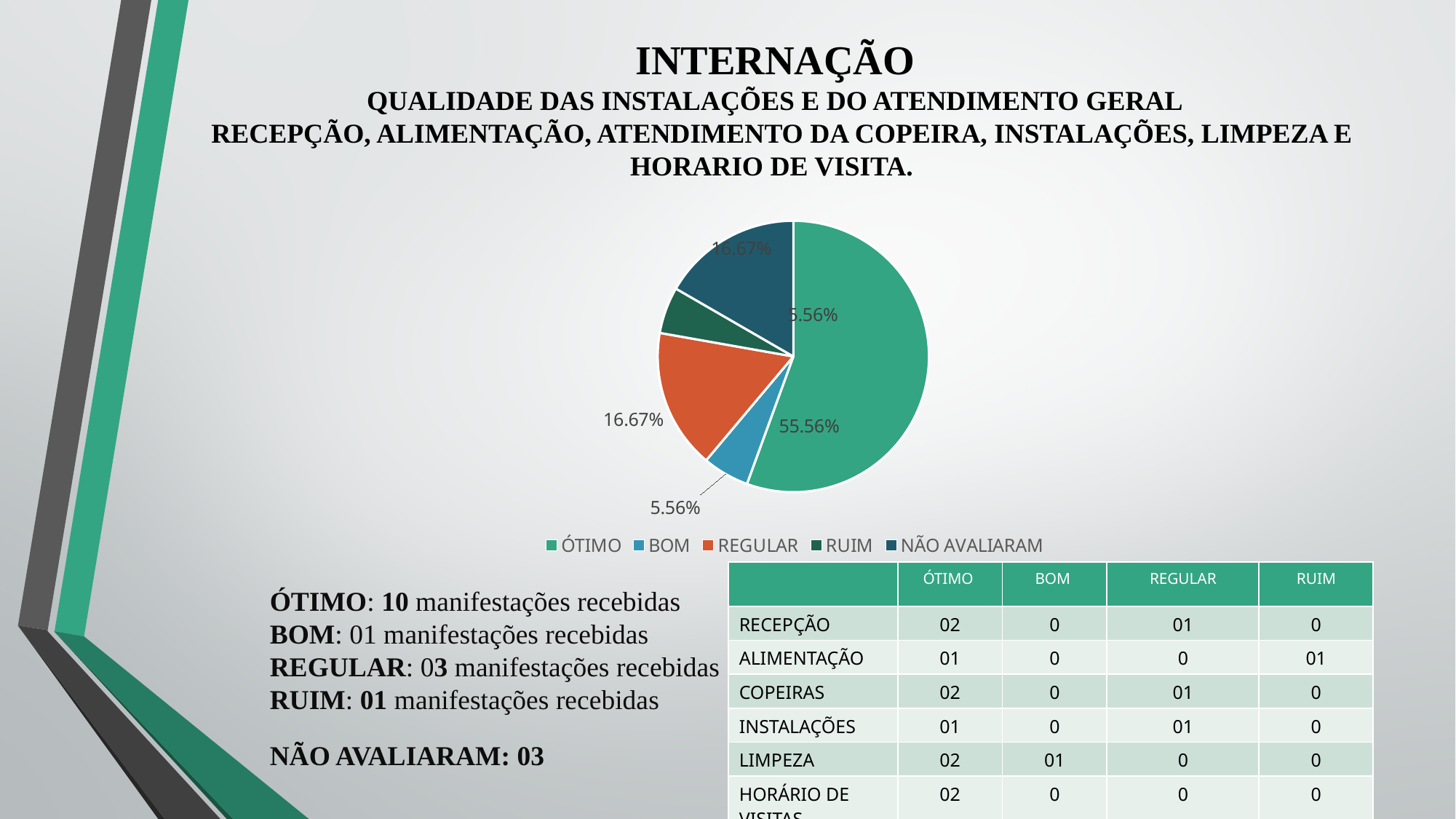
What type of chart is shown on the slide? Pie chart How many slices does the pie chart have? 5 What percentage is shown for the NÃO AVALIARAM slice of the pie chart? 16.67% What percentage is shown for the BOM slice of the pie chart? 5.56% What share of the pie chart is labelled for REGULAR? 16.67% Which category is shown in orange in the pie chart? REGULAR By how many percentage points does the ÓTIMO slice exceed the REGULAR slice in the pie chart? 38.89 percentage points Which slice is larger in the pie chart, REGULAR or BOM? REGULAR How many entries are listed in the pie chart's legend? 5 Which category has the largest slice in the pie chart? ÓTIMO What percentage of the pie chart does the ÓTIMO slice represent? 55.56% Which two categories share the smallest slice of the pie chart? BOM and RUIM